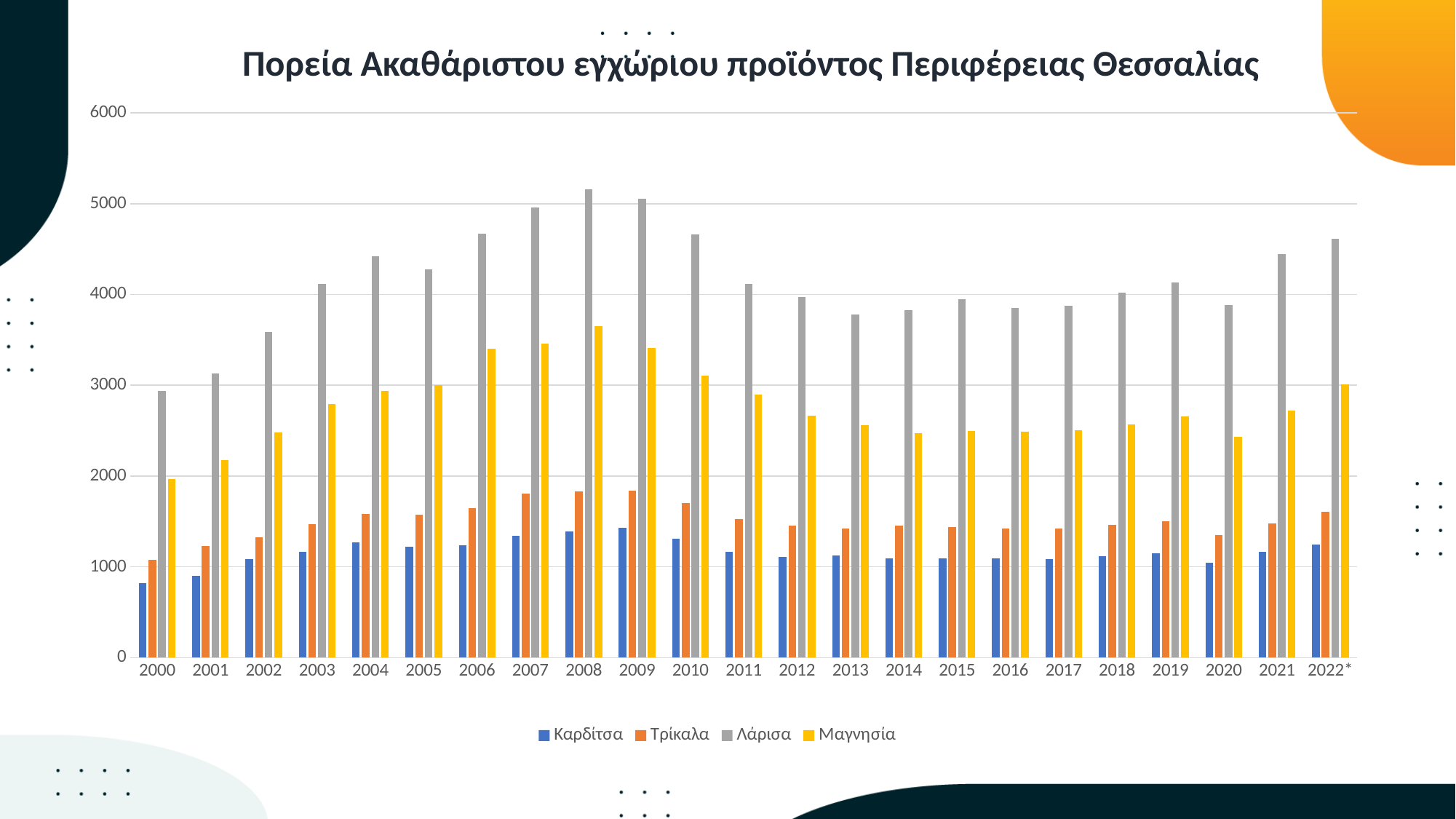
In which year is the value for Καρδίτσα lowest? 2000 Which is larger for Λάρισα: the value in 2020 or the value in 2021? 2021 What is the title of the chart? Πορεία Ακαθάριστου εγχώριου προϊόντος Περιφέρειας Θεσσαλίας Is the value for Καρδίτσα in 2000 greater or less than 1000? less Do the values for Λάρισα rise or fall from 2000 to 2008? rise What type of chart is shown on the slide? bar chart Is the value for Μαγνησία in 2012 greater or less than 3000? less How many series does the legend list? 4 How many years are shown on the x axis? 23 Is the value for Λάρισα in 2013 greater or less than 4000? less In which year does Λάρισα reach its highest value? 2008